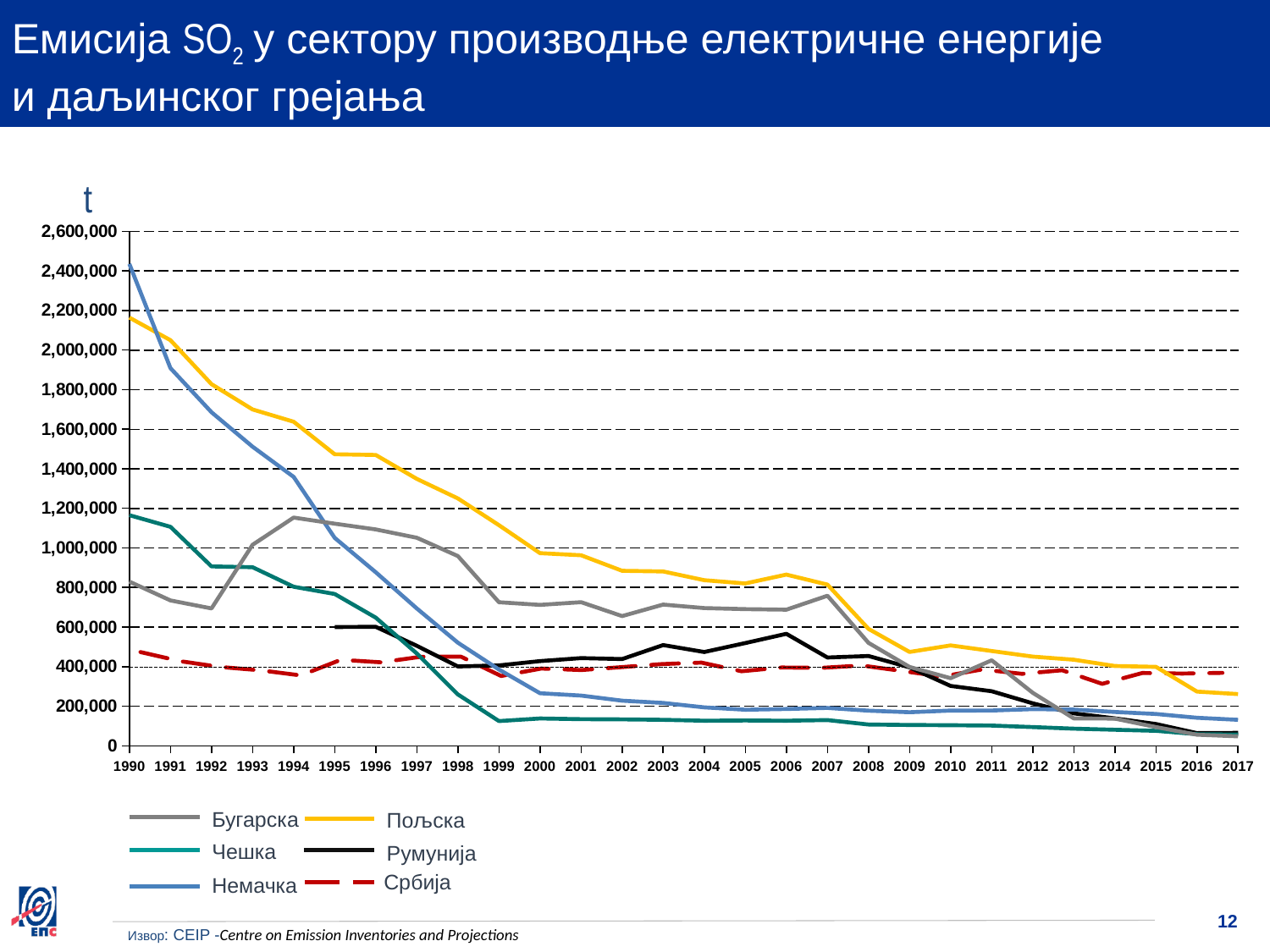
Which country has the highest SO2 emission in 1990? Немачка Is the value for Чешка in 2000 greater or less than 200,000? less Is the value for Пољска in 1990 greater or less than 2,000,000? greater Which country has the lowest SO2 emission in 1990? Србија Which country has the highest SO2 emission in 2017? Србија Is the value for Бугарска in 1994 greater or less than 1,000,000? greater In 1990, which is larger: the value for Бугарска or the value for Чешка? Чешка How many years are shown on the x axis? 28 What kind of chart is shown on the slide? line chart Does the value for Пољска rise or fall overall from 1990 to 2017? fall How many series does the legend list? 6